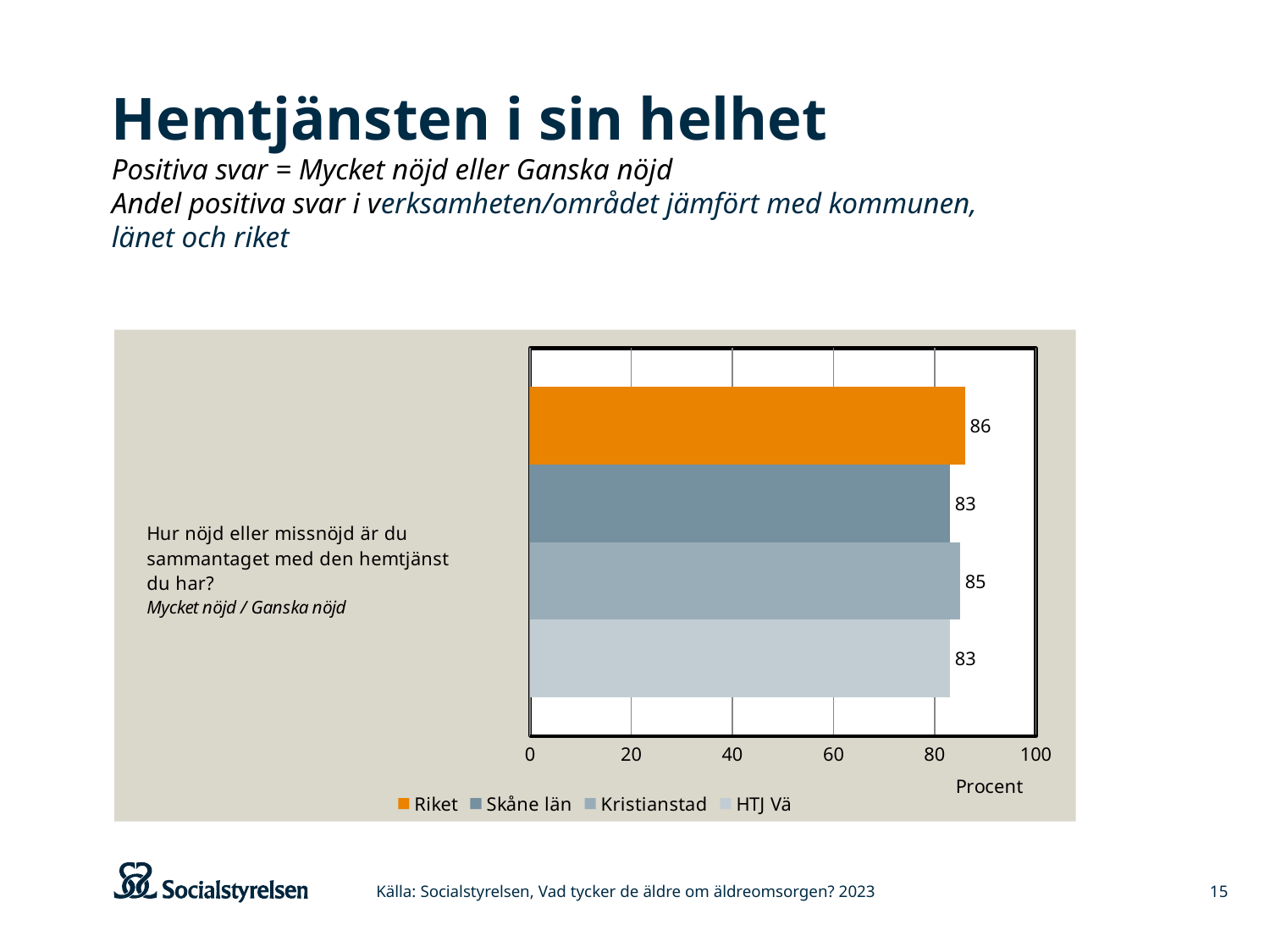
Is the value for HTJ Vä greater or less than 80? greater What is the value for HTJ Vä? 83 How many series does the legend list? 4 What is the value for Kristianstad? 85 Which series has the highest value? Riket What is the value for Riket? 86 Which is larger, the value for Riket or the value for Kristianstad? Riket What is the difference between the values for Riket and HTJ Vä? 3 What unit is shown on the horizontal axis? Procent What is the value for Skåne län? 83 What is the difference between the values for Kristianstad and Skåne län? 2 What kind of chart is shown on the slide? Bar chart